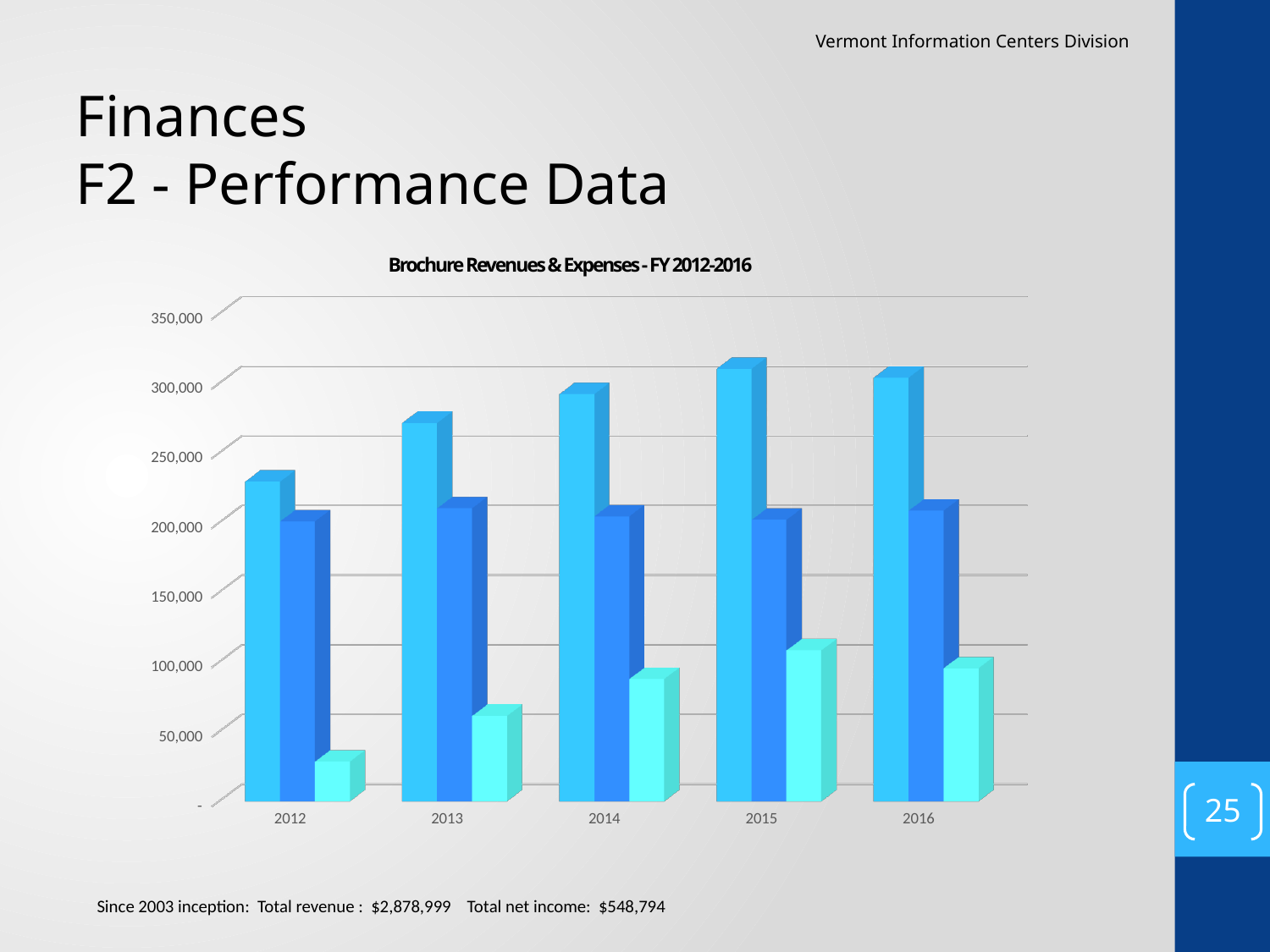
What is the title of the chart? Brochure Revenues & Expenses - FY 2012-2016 Is the value of the cyan (third) bar for 2012 greater or less than 50,000? less Do the cyan (third) bars rise or fall from 2012 to 2015? rise Is the value of the light blue (first) bar for 2013 greater or less than 250,000? greater Is the value of the light blue (first) bar for 2015 greater or less than 300,000? greater In which year is the light blue (first) bar the shortest? 2012 What kind of chart is shown on the slide? bar chart In which year is the light blue (first) bar the tallest? 2015 In which year is the cyan (third) bar the shortest? 2012 How many years are shown on the x axis of the chart? 5 Which is larger in 2014: the light blue (first) bar or the cyan (third) bar? the light blue (first) bar In which year is the cyan (third) bar the tallest? 2015